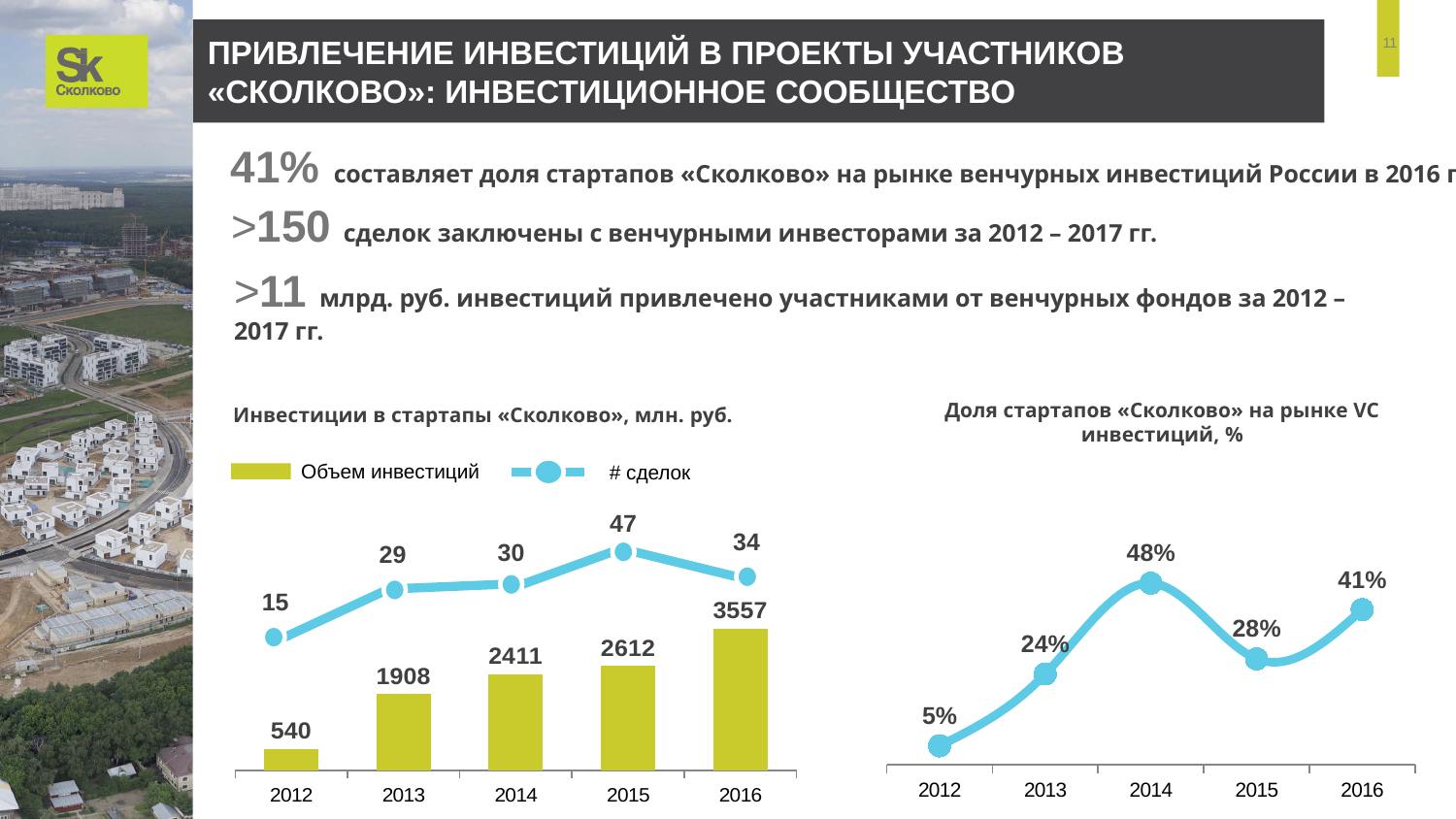
In the chart titled «Инвестиции в стартапы «Сколково», млн. руб.», does Объем инвестиций rise or fall from 2012 to 2016? rise In the chart titled «Инвестиции в стартапы «Сколково», млн. руб.», what is the value of Объем инвестиций for 2016? 3557 In the chart titled «Доля стартапов «Сколково» на рынке VC инвестиций, %», which year has the lowest value? 2012 In the chart titled «Доля стартапов «Сколково» на рынке VC инвестиций, %», which is larger, the value for 2015 or the value for 2016? 2016 In the chart titled «Инвестиции в стартапы «Сколково», млн. руб.», which year has the lowest Объем инвестиций? 2012 In the chart titled «Инвестиции в стартапы «Сколково», млн. руб.», how many сделок were there in 2015? 47 In the chart titled «Доля стартапов «Сколково» на рынке VC инвестиций, %», how many years are plotted? 5 In the chart titled «Инвестиции в стартапы «Сколково», млн. руб.», what is the difference in Объем инвестиций between 2016 and 2015? 945 In the chart titled «Доля стартапов «Сколково» на рынке VC инвестиций, %», what is the value for 2014? 48% In the chart titled «Инвестиции в стартапы «Сколково», млн. руб.», which year has the highest number of сделок? 2015 What kind of chart is the chart titled «Доля стартапов «Сколково» на рынке VC инвестиций, %»? line chart In the chart titled «Инвестиции в стартапы «Сколково», млн. руб.», how many series does the legend list? 2